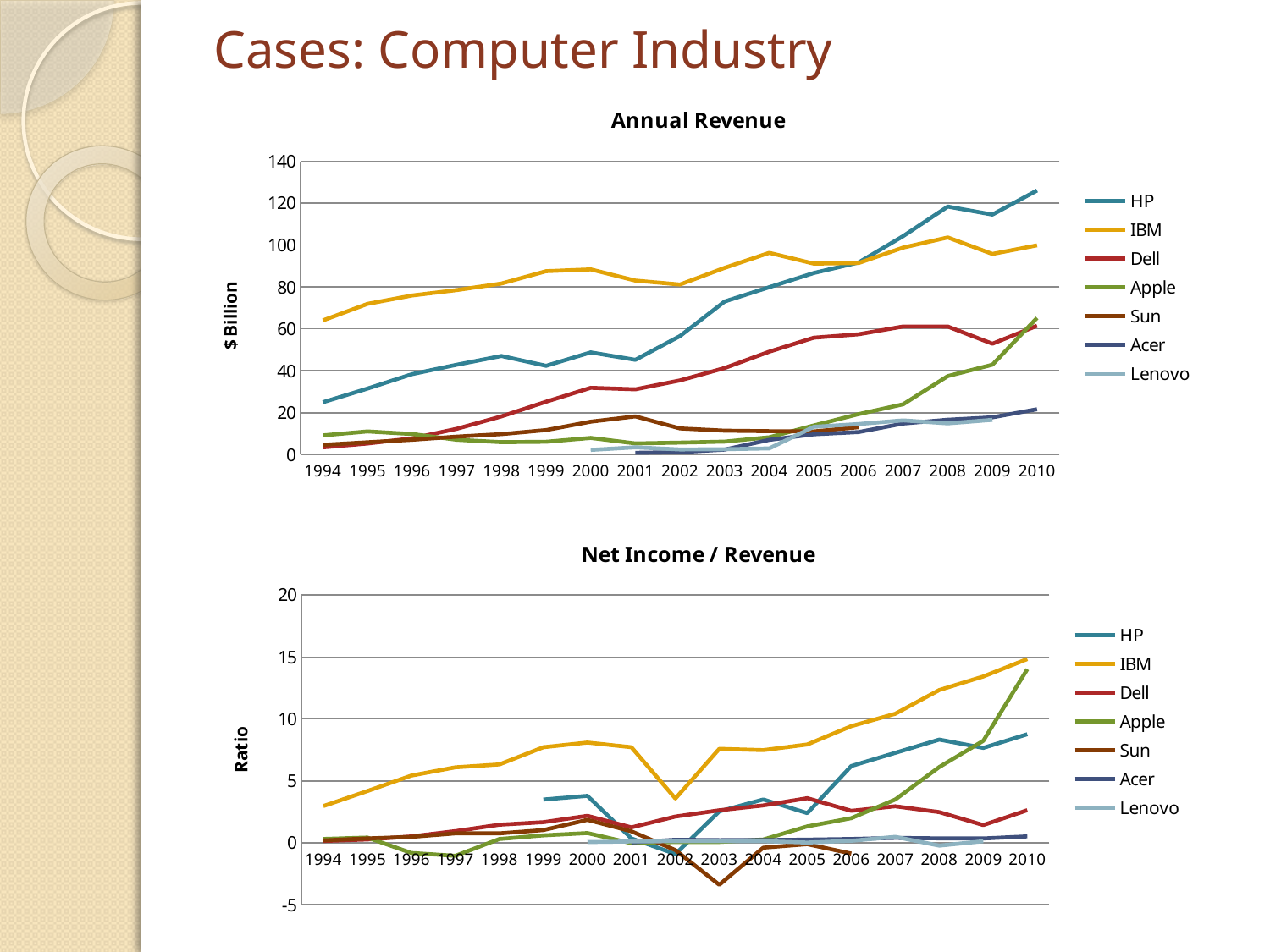
In the Net Income / Revenue chart, which company has the lowest ratio in 2003? Sun In the Net Income / Revenue chart, is the value for IBM in 2010 greater or less than 10? greater In the Annual Revenue chart, is the value for IBM in 1994 greater or less than 60? greater In the Annual Revenue chart, which company has the highest revenue in 2010? HP What is the y-axis label of the Annual Revenue chart? $ Billion In the Net Income / Revenue chart, which company has the highest ratio in 2010? IBM In the Annual Revenue chart, does HP's revenue generally rise or fall from 1994 to 2010? rise How many series does the legend of the Annual Revenue chart list? 7 In the Annual Revenue chart, is the value for HP in 2010 greater or less than 120? greater What type of chart is the Annual Revenue chart? line chart How many years are shown on the x axis of the Annual Revenue chart? 17 In the Annual Revenue chart, which is larger in 2010, the revenue of IBM or the revenue of Dell? IBM